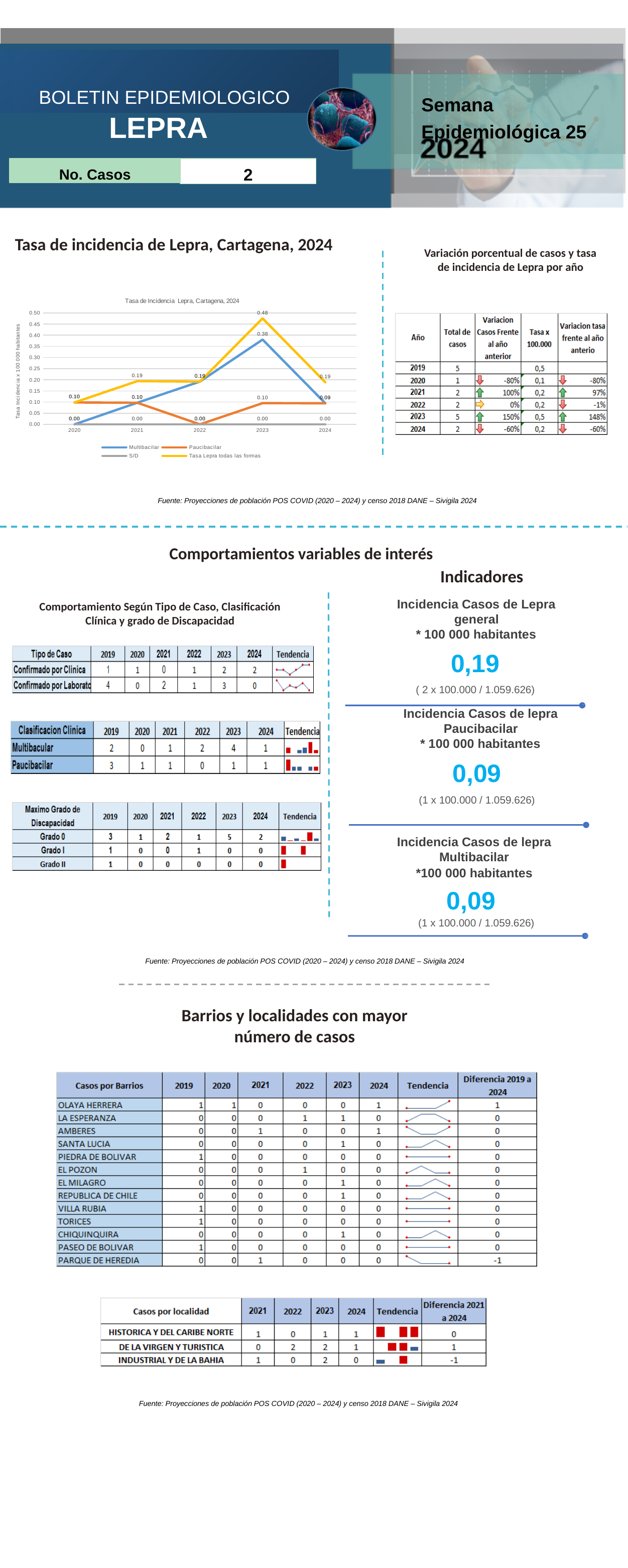
In the incidence line chart, does the Multibacilar series rise or fall from 2020 to 2023? Rise What kind of chart is shown under 'Tasa de incidencia de Lepra, Cartagena, 2024'? Line chart How many years are plotted on the x axis of the incidence line chart? 5 What is the title printed inside the incidence line chart? Tasa de Incidencia Lepra, Cartagena, 2024 In the incidence line chart, what is the Multibacilar value in 2023? 0.38 How many series does the legend of the incidence line chart list? 4 In the incidence line chart, what is the Multibacilar value in 2024? 0.09 In the incidence line chart, is the 2023 value for 'Tasa Lepra todas las formas' greater or less than 0.40? greater In the incidence line chart, what is the value of 'Tasa Lepra todas las formas' in 2023? 0.48 In the incidence line chart, what is the difference between 'Tasa Lepra todas las formas' and Multibacilar in 2023? 0.10 In the incidence line chart, which year has the highest value for 'Tasa Lepra todas las formas'? 2023 In the incidence line chart, which series is higher in 2023: Multibacilar or Paucibacilar? Multibacilar